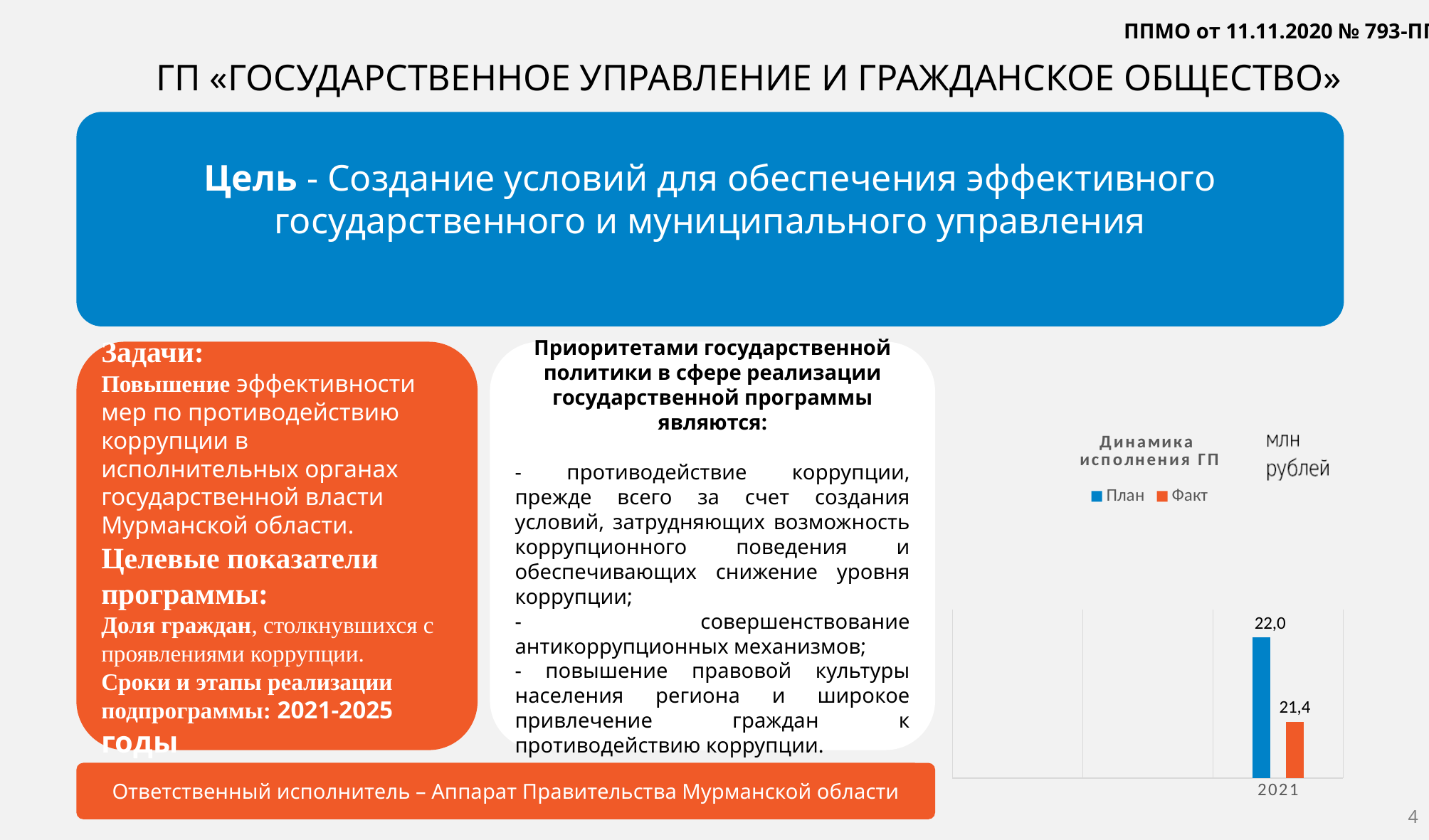
What is the value of the Факт series for 2021 in the chart? 21,4 What is the value of the План series for 2021 in the chart? 22,0 Which year is shown on the x axis of the chart? 2021 What is the title of the chart? Динамика исполнения ГП What is the difference between the План and Факт values for 2021? 0,6 What kind of chart is shown on the slide? Bar chart Which series has the higher value for 2021, План or Факт? План How many categories are shown on the x axis of the chart? 1 How many series does the chart legend list? 2 What unit is indicated next to the chart title? млн рублей